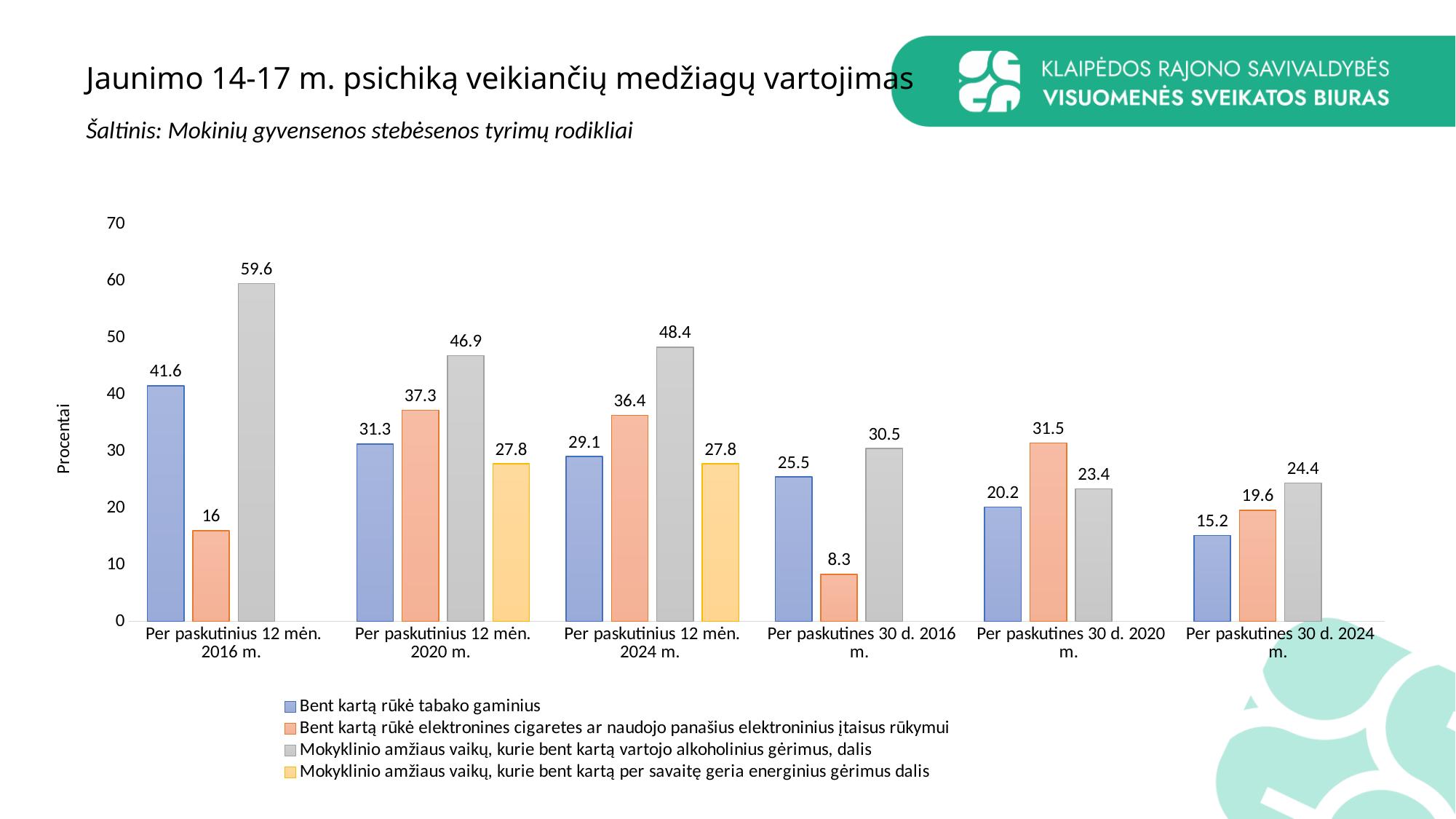
In the category 'Per paskutines 30 d. 2020 m.', which is larger: 'Bent kartą rūkė tabako gaminius' or 'Bent kartą rūkė elektronines cigaretes ar naudojo panašius elektroninius įtaisus rūkymui'? Bent kartą rūkė elektronines cigaretes ar naudojo panašius elektroninius įtaisus rūkymui What is the value for 'Bent kartą rūkė tabako gaminius' in the category 'Per paskutinius 12 mėn. 2016 m.'? 41.6 What is the label of the y axis? Procentai Which category has the highest value for 'Mokyklinio amžiaus vaikų, kurie bent kartą vartojo alkoholinius gėrimus, dalis'? Per paskutinius 12 mėn. 2016 m. How many categories are shown on the x axis? 6 What is the value for 'Bent kartą rūkė elektronines cigaretes ar naudojo panašius elektroninius įtaisus rūkymui' in the category 'Per paskutines 30 d. 2016 m.'? 8.3 Across the three 'Per paskutinius 12 mėn.' categories (2016, 2020, 2024), do the values for 'Bent kartą rūkė tabako gaminius' rise or fall? Fall Which category has the lowest value for 'Bent kartą rūkė tabako gaminius'? Per paskutines 30 d. 2024 m. What is the value for 'Mokyklinio amžiaus vaikų, kurie bent kartą vartojo alkoholinius gėrimus, dalis' in the category 'Per paskutinius 12 mėn. 2024 m.'? 48.4 What kind of chart is shown on the slide? Bar chart How many series does the legend list? 4 What is the difference between the 'Bent kartą rūkė tabako gaminius' values for 'Per paskutinius 12 mėn. 2016 m.' and 'Per paskutinius 12 mėn. 2024 m.'? 12.5